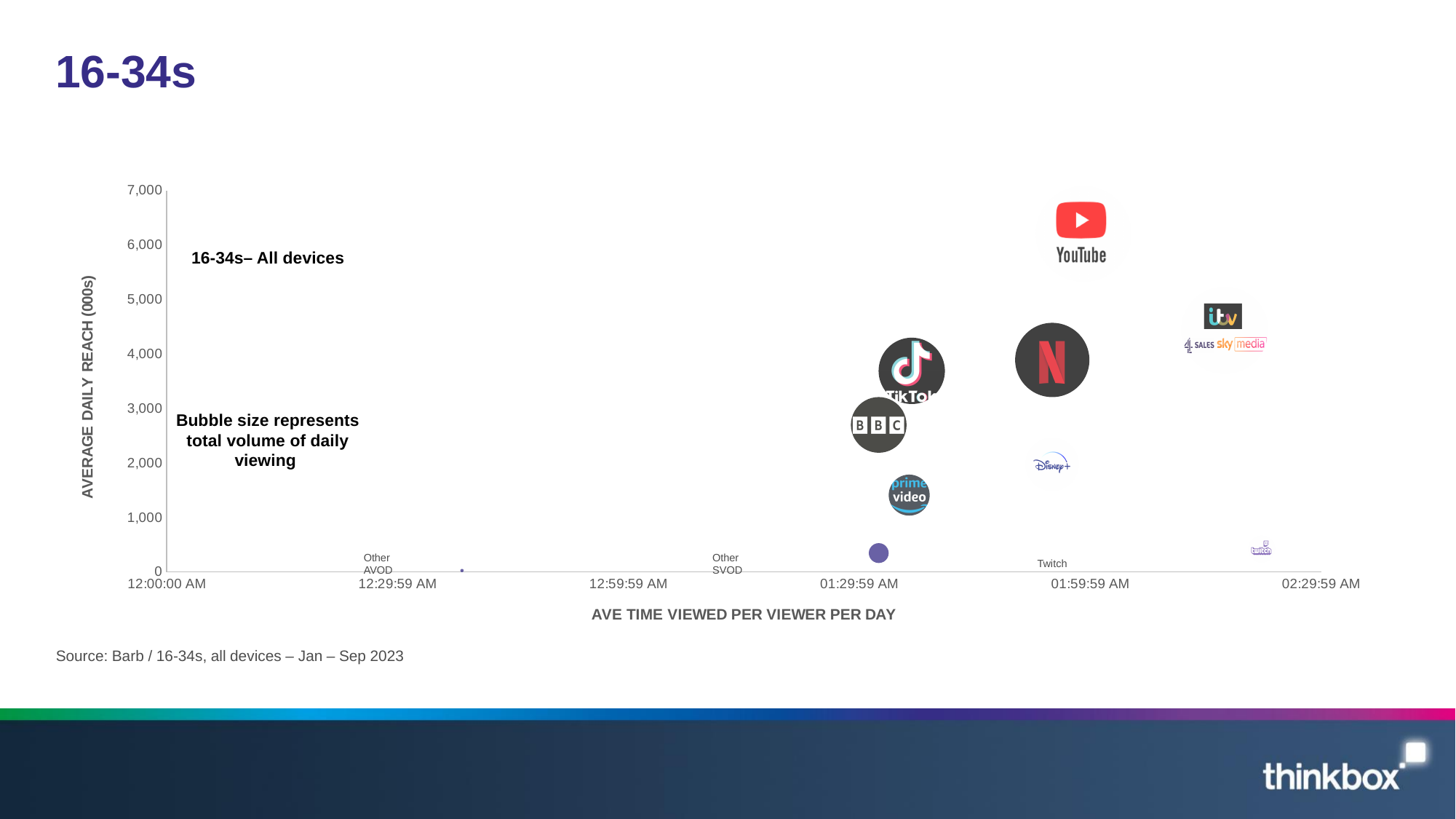
Which has the higher average daily reach, Netflix or BBC? Netflix Which has the longer average time viewed per viewer per day, YouTube or BBC? YouTube Is the average daily reach for Netflix greater or less than 3,000? greater What kind of chart is shown on the slide? Bubble chart Which platform has the highest average daily reach? YouTube What is the label of the vertical axis? AVERAGE DAILY REACH (000s) Is the average daily reach for Prime Video greater or less than 2,000? less Is the average daily reach for BBC greater or less than 3,000? less What does the bubble size represent in the chart? Total volume of daily viewing